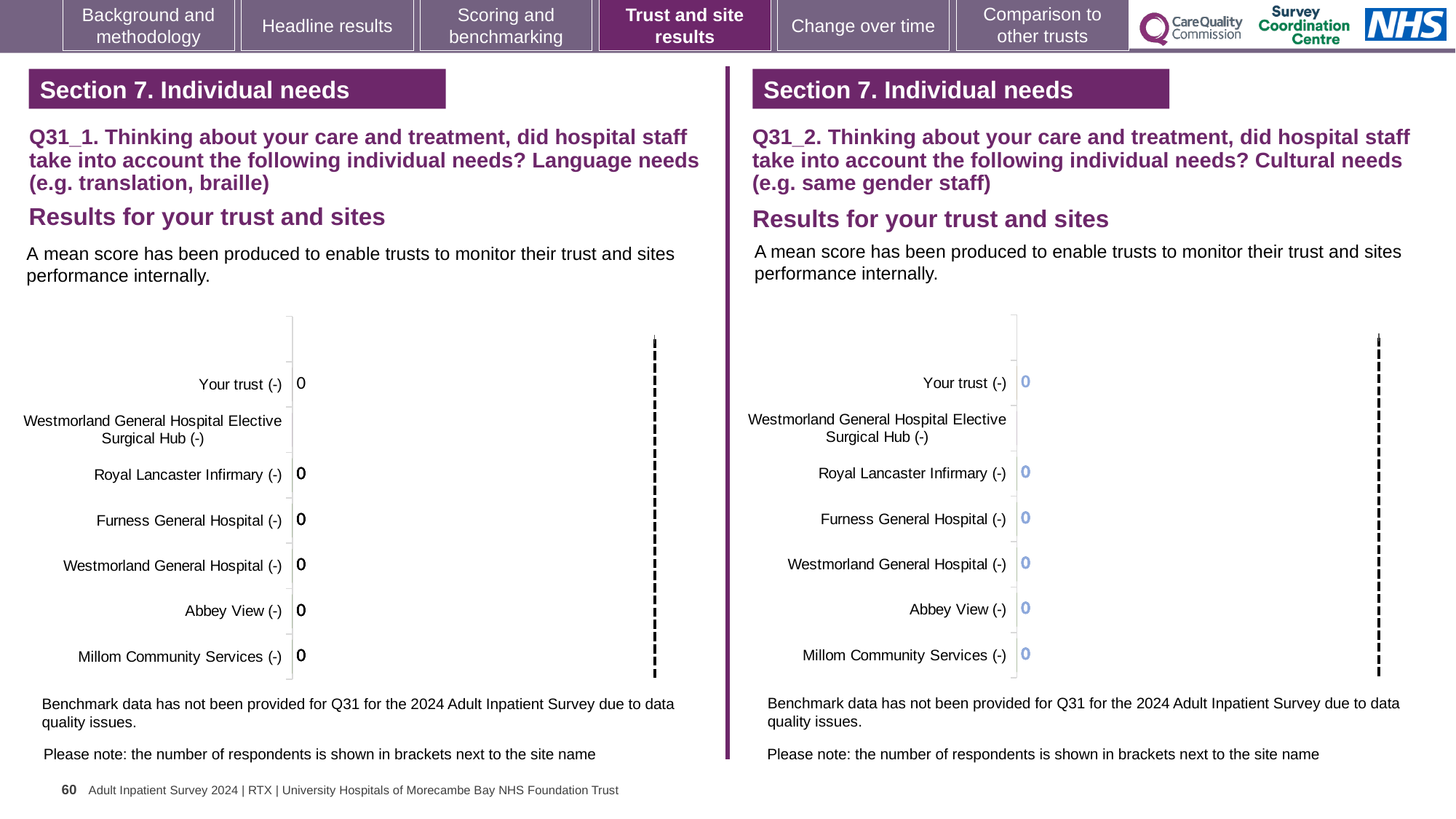
How many categories are listed on the y axis of the right chart (Q31_2, Cultural needs)? 7 In the right chart (Q31_2, Cultural needs), what value is shown for Furness General Hospital? 0 In the right chart (Q31_2, Cultural needs), which category has no data label shown? Westmorland General Hospital Elective Surgical Hub (-) In the left chart (Q31_1, Language needs), what is the difference between the values for Your trust and Furness General Hospital? 0 In the right chart (Q31_2, Cultural needs), what value is shown for Westmorland General Hospital? 0 What kind of chart is the left chart (Q31_1, Language needs)? Bar chart How many categories are listed on the y axis of the left chart (Q31_1, Language needs)? 7 In the left chart (Q31_1, Language needs), what value is shown for Abbey View? 0 In the left chart (Q31_1, Language needs), what value is shown for Your trust? 0 In the left chart (Q31_1, Language needs), what value is shown for Royal Lancaster Infirmary? 0 In the right chart (Q31_2, Cultural needs), what value is shown for Millom Community Services? 0 In the left chart (Q31_1, Language needs), what is the first category listed at the top of the y axis? Your trust (-)